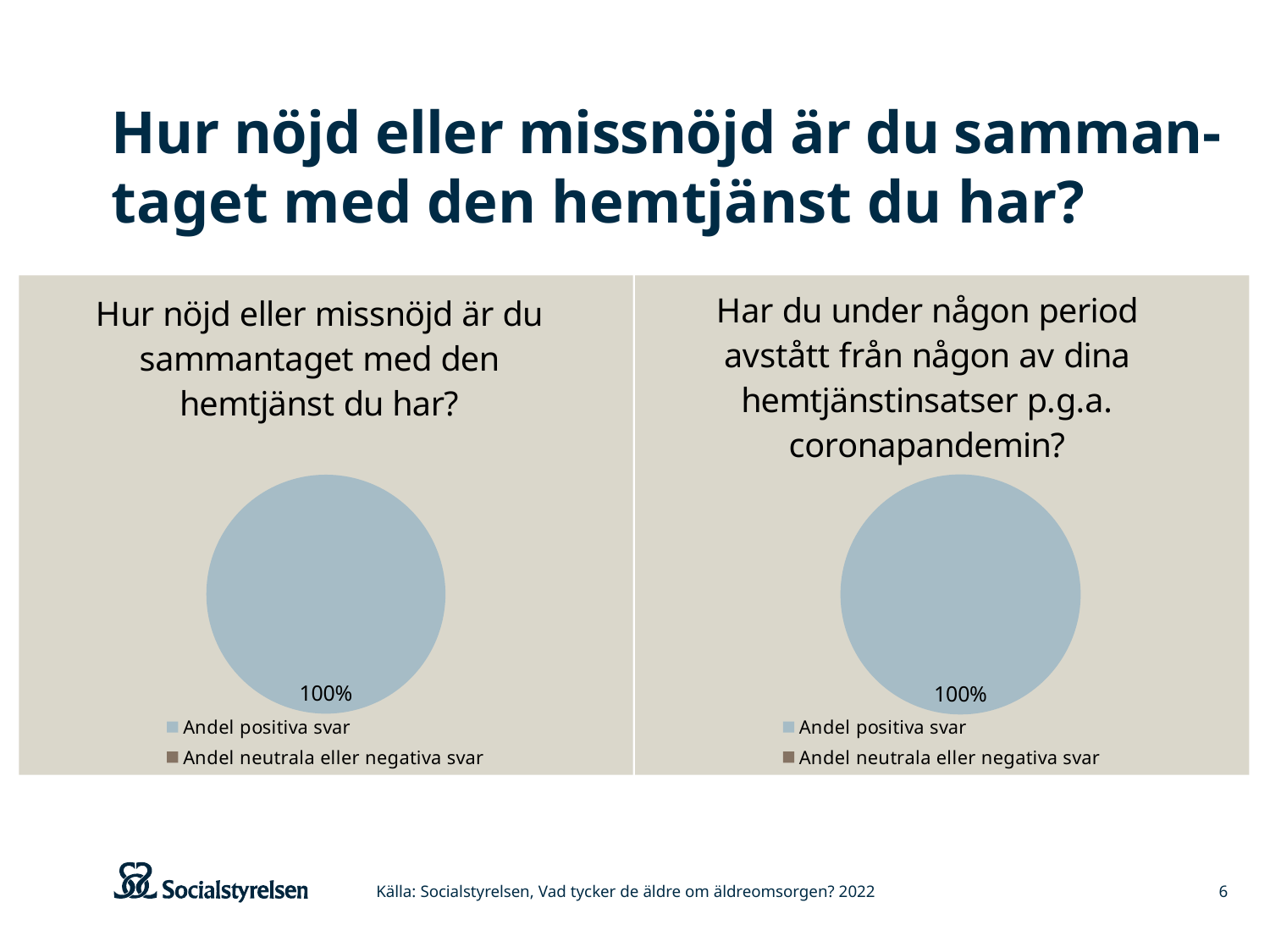
What kind of chart is the right chart? Pie chart What is the title of the right chart? Har du under någon period avstått från någon av dina hemtjänstinsatser p.g.a. coronapandemin? In the right chart, which legend category makes up the whole pie? Andel positiva svar What kind of chart is the left chart? Pie chart How many entries does the legend of the left chart list? 2 In the right chart, what share of the pie is labelled for 'Andel positiva svar'? 100% Is the share for 'Andel positiva svar' in the left chart greater or less than 50%? greater How many entries does the legend of the right chart list? 2 How many pie charts are shown on the slide? 2 In the left chart, what share of the pie is labelled for 'Andel positiva svar'? 100% In the left chart, which legend category makes up the whole pie? Andel positiva svar What is the second legend entry in the left chart? Andel neutrala eller negativa svar